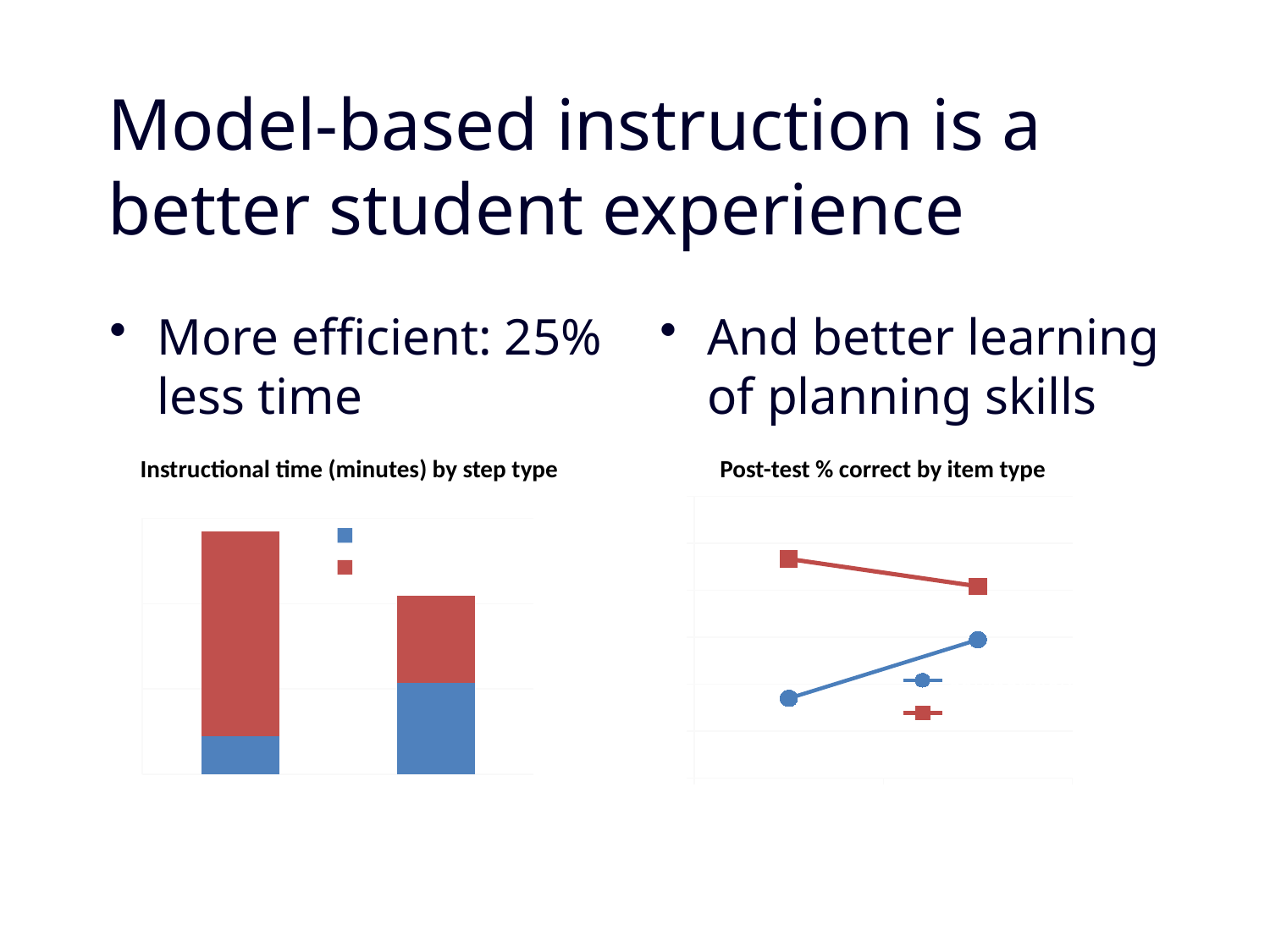
In the 'Post-test % correct by item type' chart, does the red line with square markers rise or fall from left to right? fall In the 'Post-test % correct by item type' chart, does the blue line with circle markers rise or fall from left to right? rise How many lines are plotted in the 'Post-test % correct by item type' chart? 2 What kind of chart is the 'Post-test % correct by item type' chart? line chart What is the title of the chart on the right side of the slide? Post-test % correct by item type What kind of chart is the 'Instructional time (minutes) by step type' chart? stacked bar chart How many bars are shown in the 'Instructional time (minutes) by step type' chart? 2 How many series does the legend of the 'Instructional time (minutes) by step type' chart show? 2 In the 'Post-test % correct by item type' chart, which line is higher at the left-hand point, the red line or the blue line? the red line In the 'Instructional time (minutes) by step type' chart, which bar has the larger blue segment, the left bar or the right bar? the right bar What is the title of the chart on the left side of the slide? Instructional time (minutes) by step type In the 'Instructional time (minutes) by step type' chart, which bar has the greater total height, the left bar or the right bar? the left bar